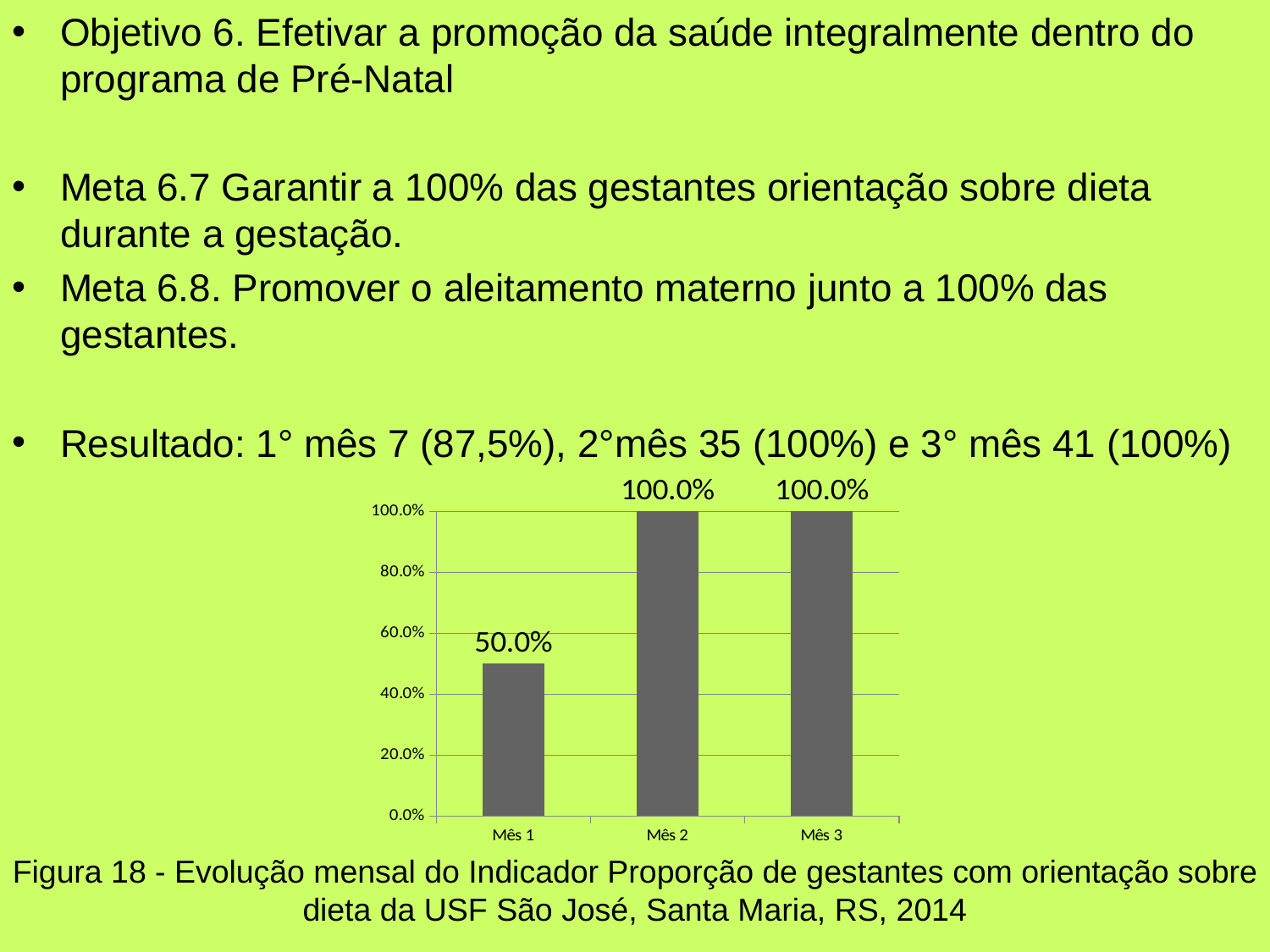
Do the values rise or fall from Mês 1 to Mês 2? rise Is the value for Mês 2 greater or less than 80.0%? greater What kind of chart is shown on the slide? bar chart What is the value for Mês 1 in the chart? 50.0% What is the difference between the values for Mês 2 and Mês 1? 50.0% What is the value for Mês 2 in the chart? 100.0% What is the figure number given in the caption below the chart? Figura 18 What is the value for Mês 3 in the chart? 100.0% Is the value for Mês 1 greater or less than 60.0%? less Which is larger, the value for Mês 1 or the value for Mês 3? Mês 3 How many months are shown on the x axis of the chart? 3 Which month has the lowest value in the chart? Mês 1